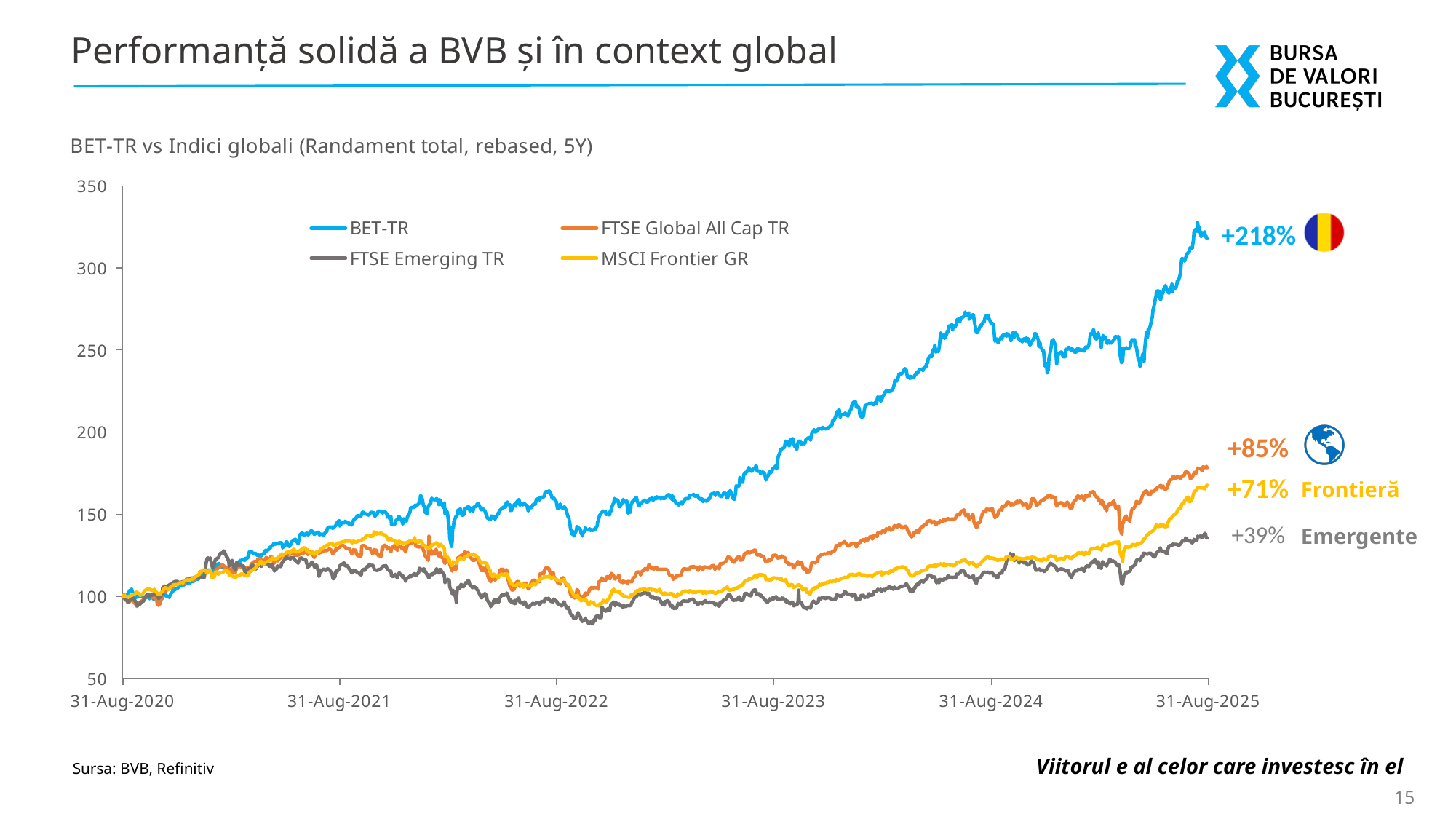
What is the difference in percentage points between the annotated returns of BET-TR and FTSE Global All Cap TR? 133 What is the 5-year total return annotated for the Emergente (FTSE Emerging TR) series? +39% Which series has the highest annotated 5-year return? BET-TR How many series does the legend list? 4 What is the 5-year total return annotated for the Frontieră (MSCI Frontier GR) series? +71% What is the 5-year total return annotated for BET-TR? +218% Is the BET-TR line at 31-Aug-2025 greater or less than 300? greater Which has a larger annotated return, MSCI Frontier GR or FTSE Emerging TR? MSCI Frontier GR What is the 5-year total return annotated for FTSE Global All Cap TR? +85% What kind of chart is shown on the slide? line chart Which series has the lowest annotated 5-year return? FTSE Emerging TR What is the title of the chart? BET-TR vs Indici globali (Randament total, rebased, 5Y)